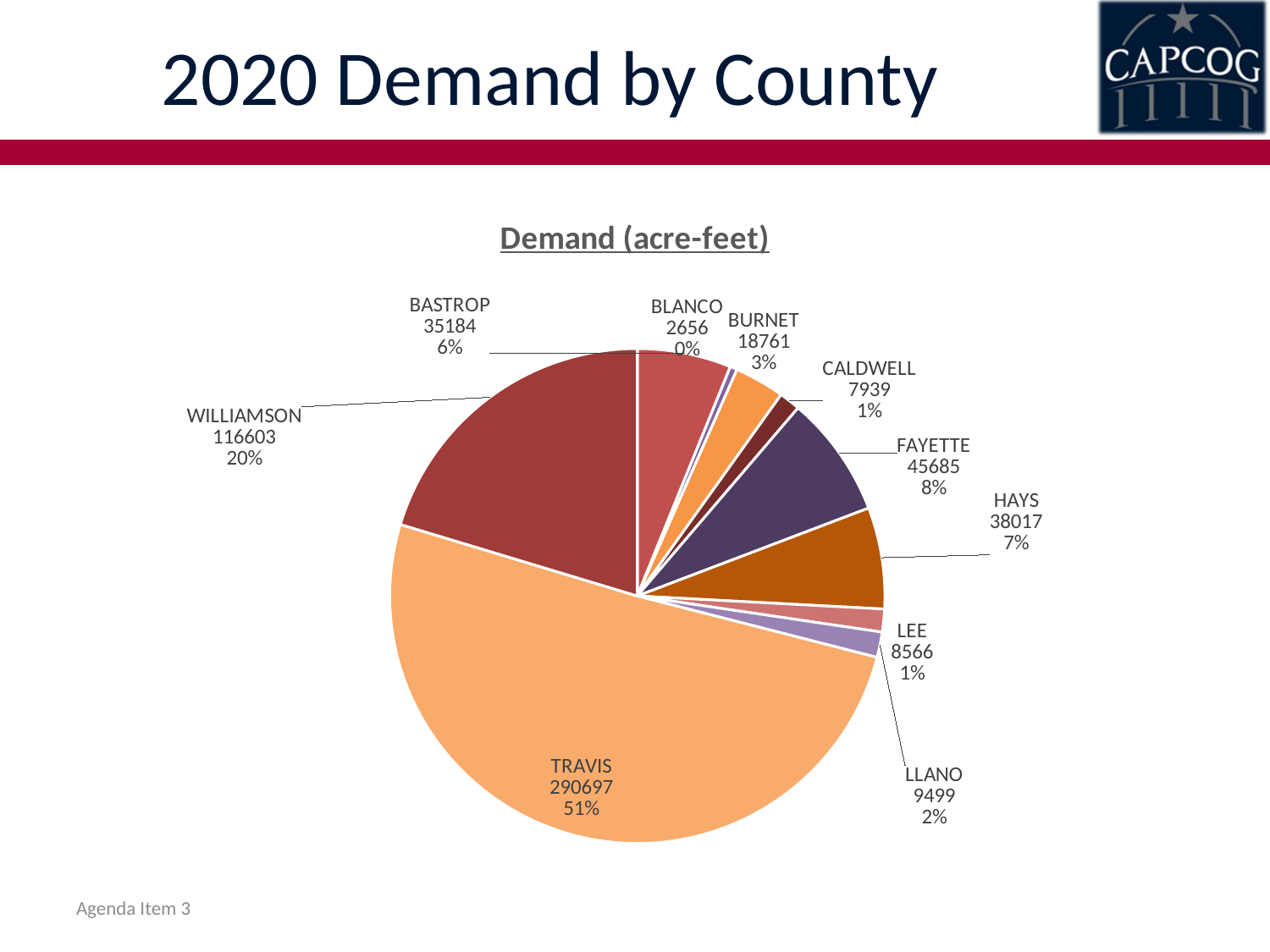
What is the demand value for Fayette? 45685 Which county has the largest demand? Travis What is the demand value for Travis? 290697 Which has the larger demand, Bastrop or Hays? Hays Which county has the smallest demand? Blanco What share of the pie does Hays represent? 7% How many counties are shown in the pie chart? 10 What is the demand value for Williamson? 116603 What kind of chart is shown on the slide? pie chart What is the difference in demand between Travis and Williamson? 174094 What is the title of the chart? Demand (acre-feet) What share of the pie does Williamson represent? 20%